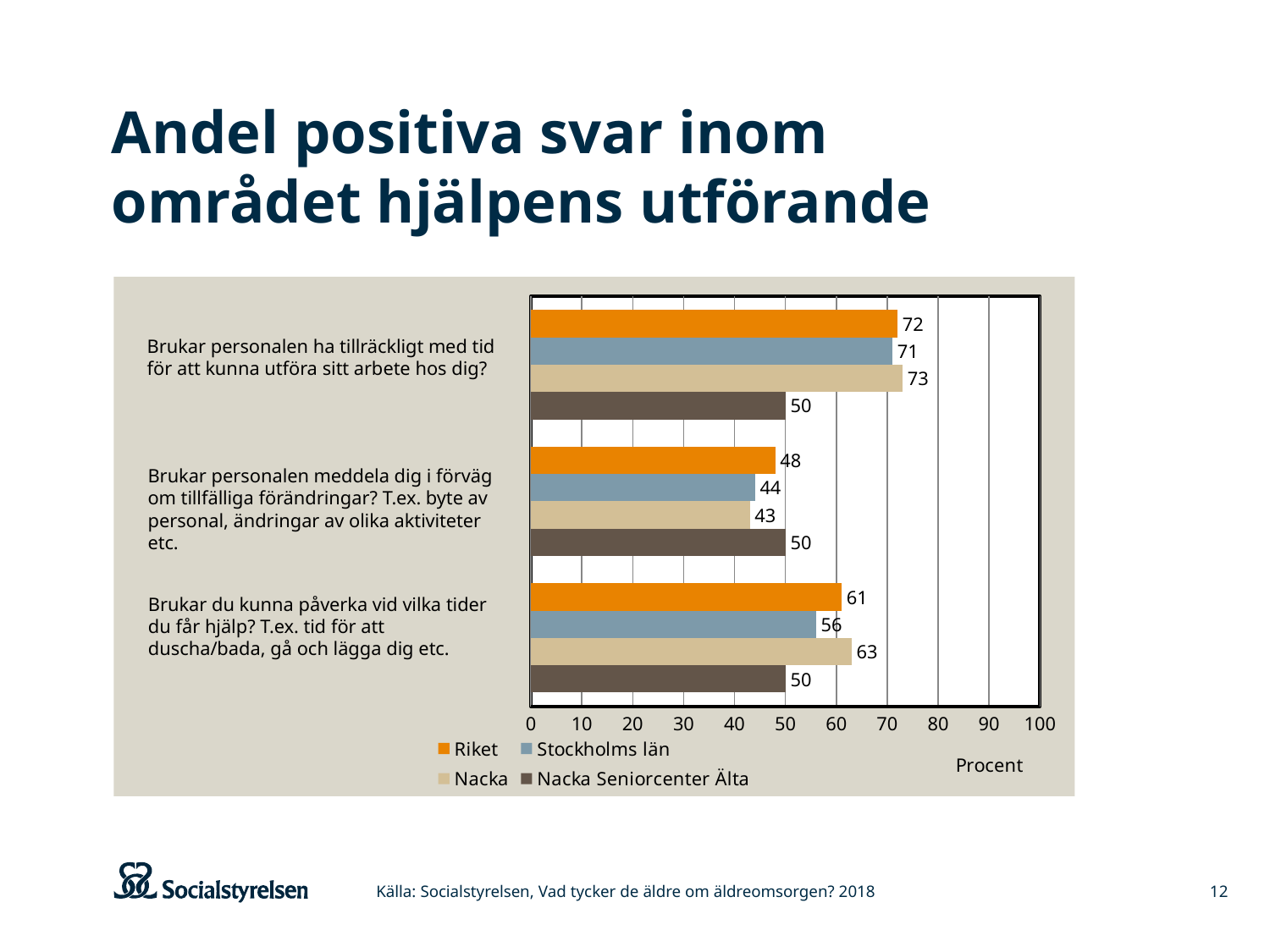
For the question "Brukar personalen meddela dig i förväg om tillfälliga förändringar?", which is larger: Riket or Stockholms län? Riket What is the value for Nacka for the question "Brukar personalen ha tillräckligt med tid för att kunna utföra sitt arbete hos dig?"? 73 Which series has the lowest value for the question "Brukar personalen meddela dig i förväg om tillfälliga förändringar?"? Nacka What is the difference between Nacka and Nacka Seniorcenter Älta for the question "Brukar du kunna påverka vid vilka tider du får hjälp?"? 13 What is the value for Stockholms län for the question "Brukar du kunna påverka vid vilka tider du får hjälp?"? 56 What is the value for Nacka Seniorcenter Älta for the question "Brukar personalen meddela dig i förväg om tillfälliga förändringar?"? 50 How many question categories are shown on the chart? 3 What kind of chart is shown on the slide? Bar chart Which series has the highest value for the question "Brukar personalen ha tillräckligt med tid för att kunna utföra sitt arbete hos dig?"? Nacka What is the label of the x axis? Procent How many series does the legend list? 4 What is the value for Riket for the question "Brukar personalen meddela dig i förväg om tillfälliga förändringar?"? 48